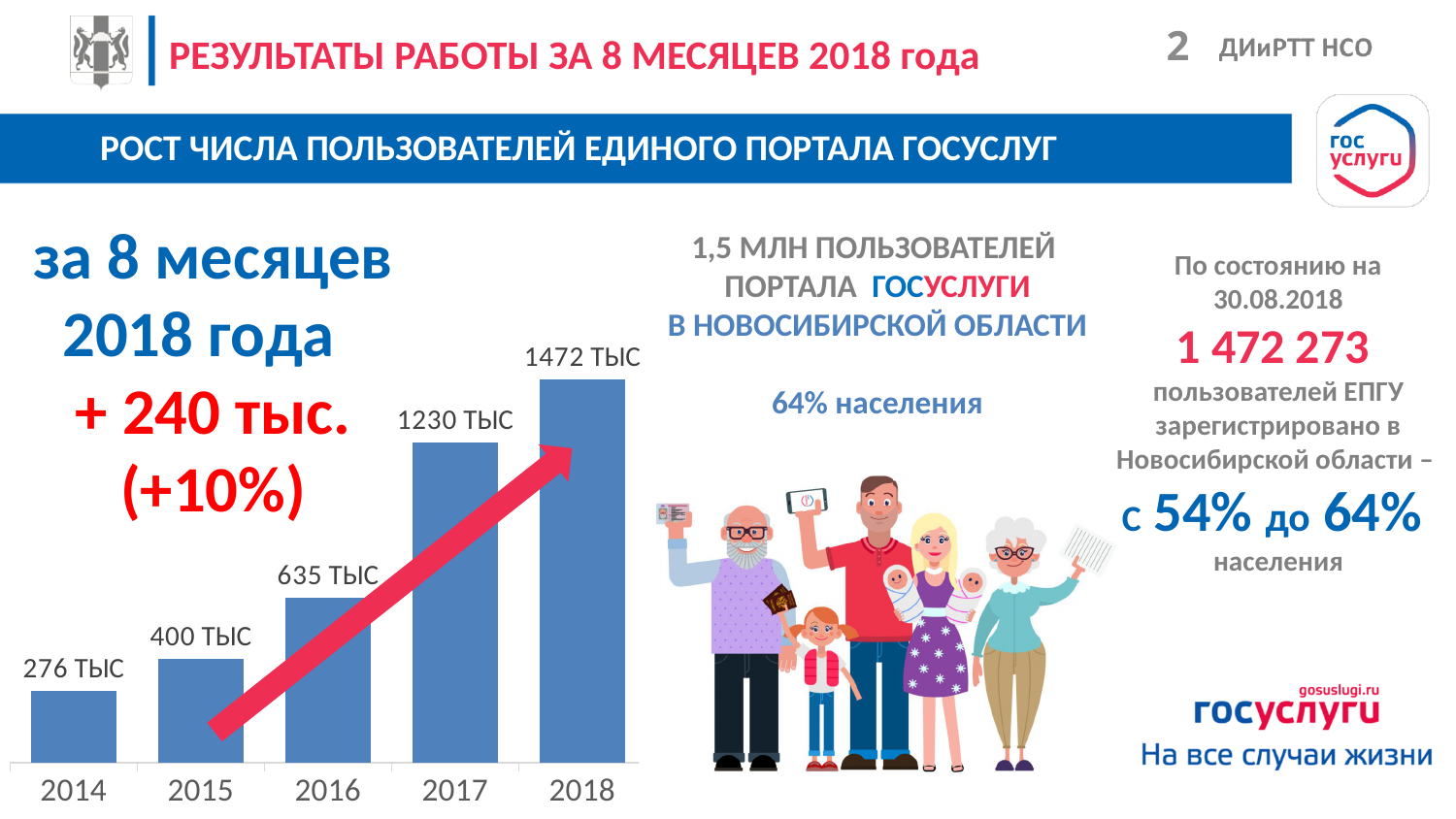
What is the value for 2018? 1472 ТЫС What is the difference between the values for 2018 and 2017? 242 ТЫС What colour are the bars in the chart? blue Which is larger, the value for 2016 or the value for 2015? 2016 How many years are shown on the x axis? 5 Which year has the highest value? 2018 What kind of chart is shown? bar chart Do the values rise or fall from 2014 to 2018? rise What is the value for 2016? 635 ТЫС What is the difference between the values for 2015 and 2014? 124 ТЫС Which year has the lowest value? 2014 What is the value for 2014? 276 ТЫС